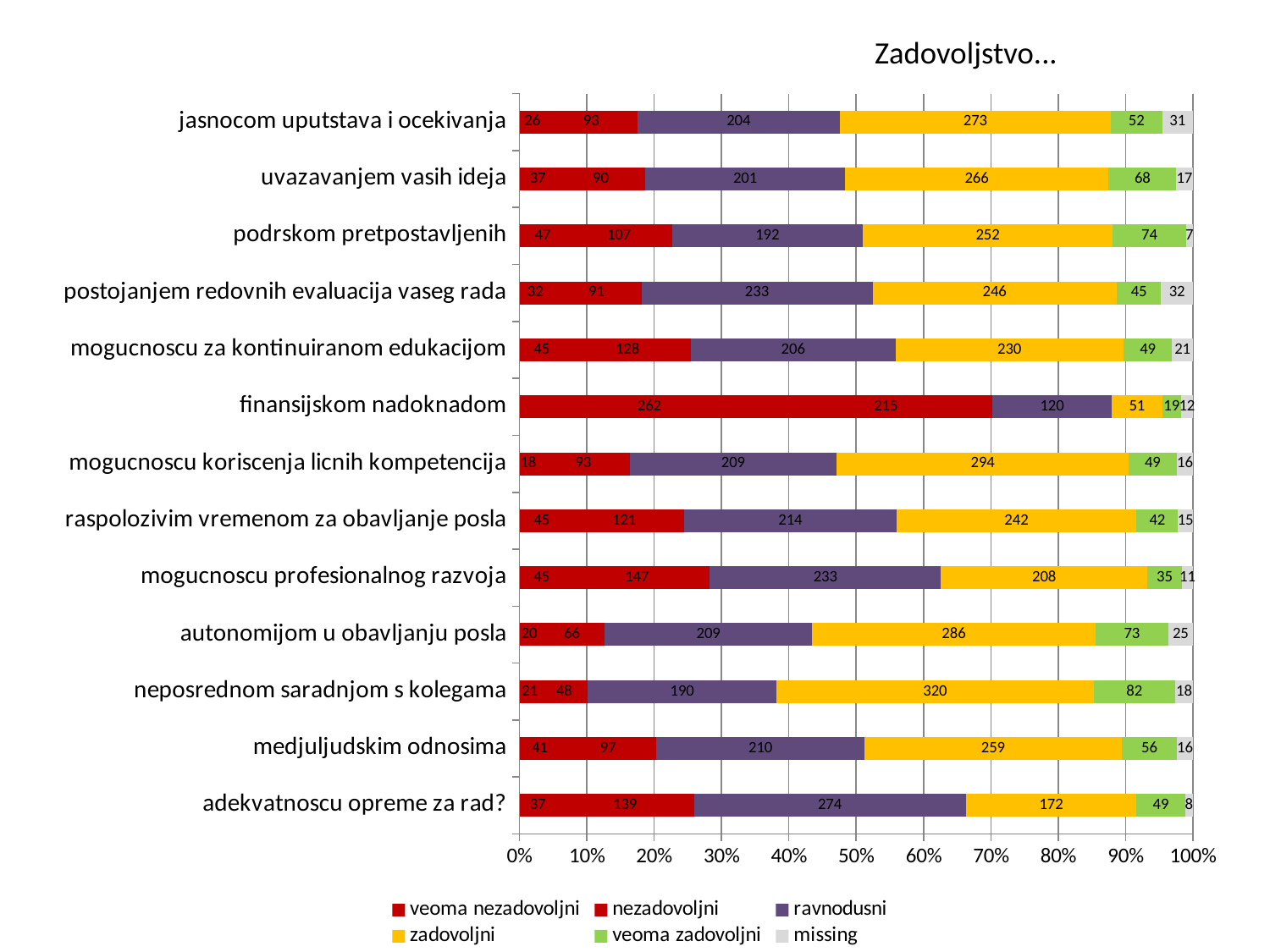
How many series does the legend list? 6 Which category has the lowest 'missing' value? podrskom pretpostavljenih Which category has the highest 'zadovoljni' value? neposrednom saradnjom s kolegama What kind of chart is shown on the slide? stacked bar chart How many categories (rows) does the chart show? 13 What is the difference between the 'veoma zadovoljni' values for 'neposrednom saradnjom s kolegama' and 'podrskom pretpostavljenih'? 8 What is the 'zadovoljni' value for 'neposrednom saradnjom s kolegama'? 320 What is the 'ravnodusni' value for 'adekvatnoscu opreme za rad?'? 274 What is the total of all segments in the 'jasnocom uputstava i ocekivanja' bar? 679 Which is larger: the 'nezadovoljni' value for 'mogucnoscu profesionalnog razvoja' or for 'adekvatnoscu opreme za rad?'? mogucnoscu profesionalnog razvoja What is the title of the chart? Zadovoljstvo… What is the 'veoma nezadovoljni' value for 'finansijskom nadoknadom'? 262